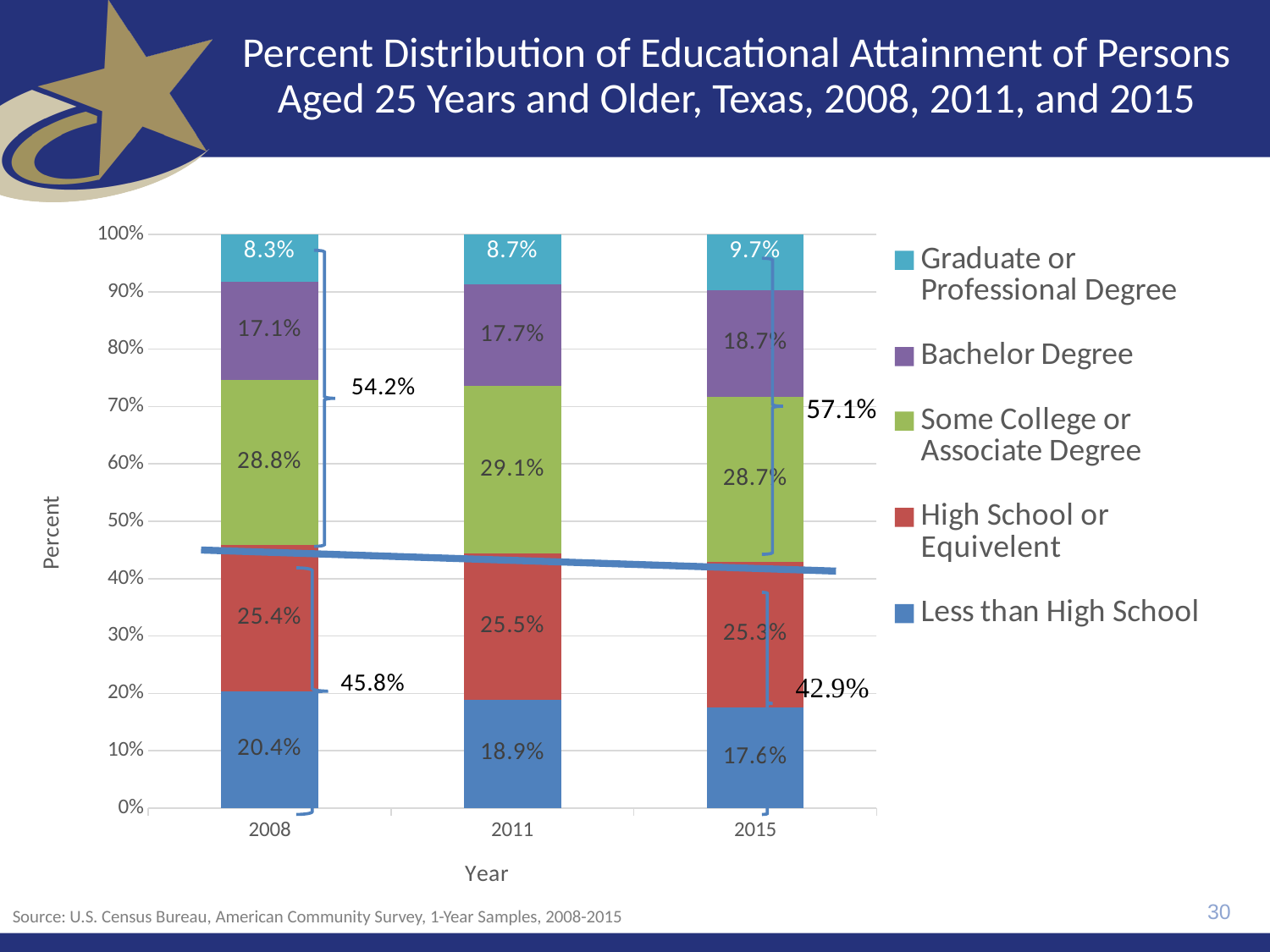
What is the difference between the Less than High School values for 2008 and 2015? 2.8% In which year is the Bachelor Degree share the highest? 2015 What combined percentage is annotated for the top three categories (Some College or higher) in 2015? 57.1% Does the Less than High School share rise or fall from 2008 to 2015? Fall What is the value for Graduate or Professional Degree in 2015? 9.7% What is the value for Some College or Associate Degree in 2011? 29.1% How many series does the legend list? 5 How many years are shown on the x axis? 3 What type of chart is shown on the slide? Stacked bar chart What is the value for Less than High School in 2008? 20.4% In which year is the Less than High School share the lowest? 2015 Which is larger, the Graduate or Professional Degree value in 2011 or in 2015? 2015